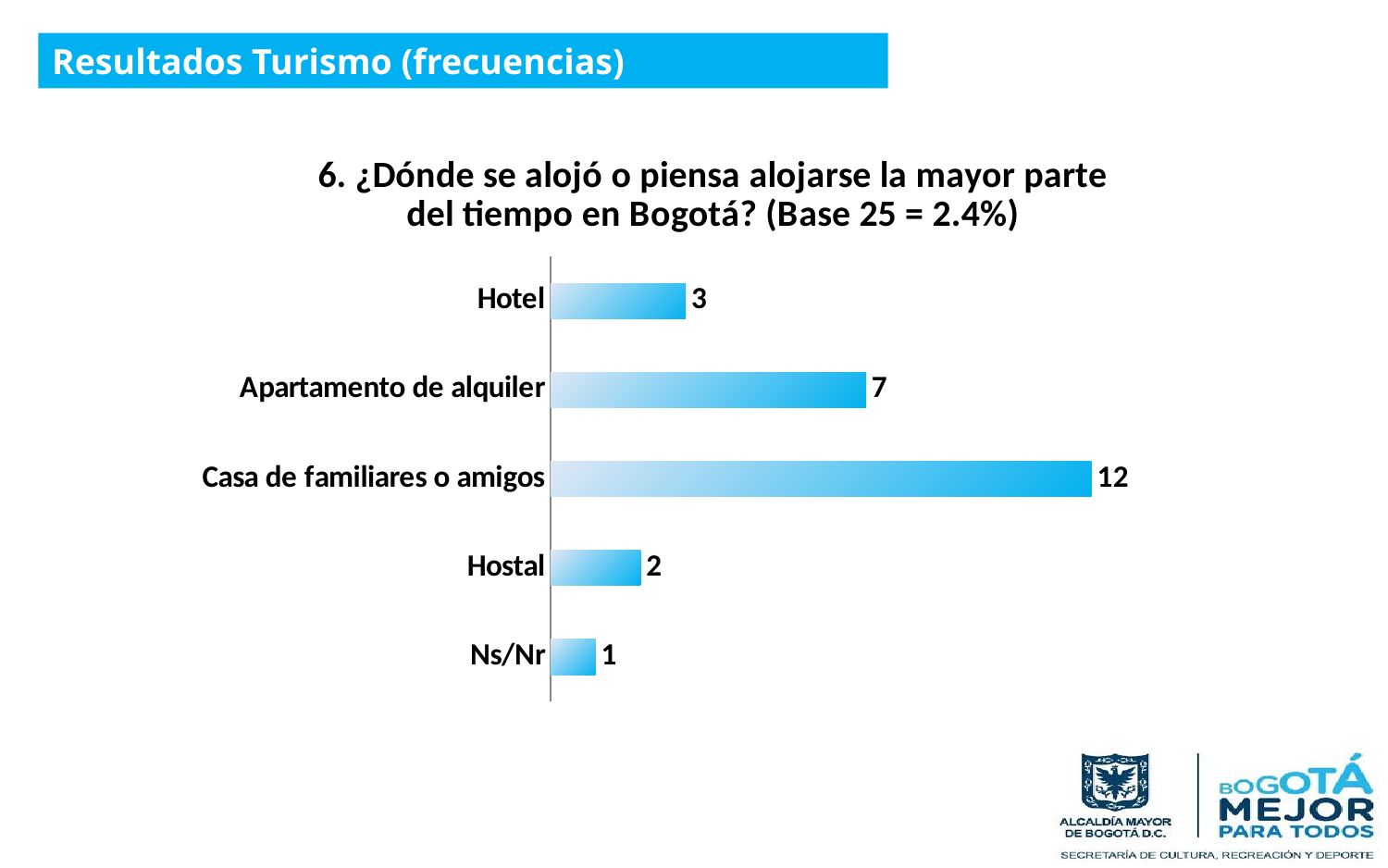
What is the base stated in the chart title? Base 25 = 2.4% What is the value for Hotel? 3 What is the value for Hostal? 2 What kind of chart is shown on the slide? Bar chart What is the value for Ns/Nr? 1 What is the value for Casa de familiares o amigos? 12 Which is larger, the value for Hotel or the value for Hostal? Hotel What is the difference between the values for Casa de familiares o amigos and Apartamento de alquiler? 5 Which category has the highest value? Casa de familiares o amigos What is the value for Apartamento de alquiler? 7 How many categories are shown in the chart? 5 Which category has the lowest value? Ns/Nr